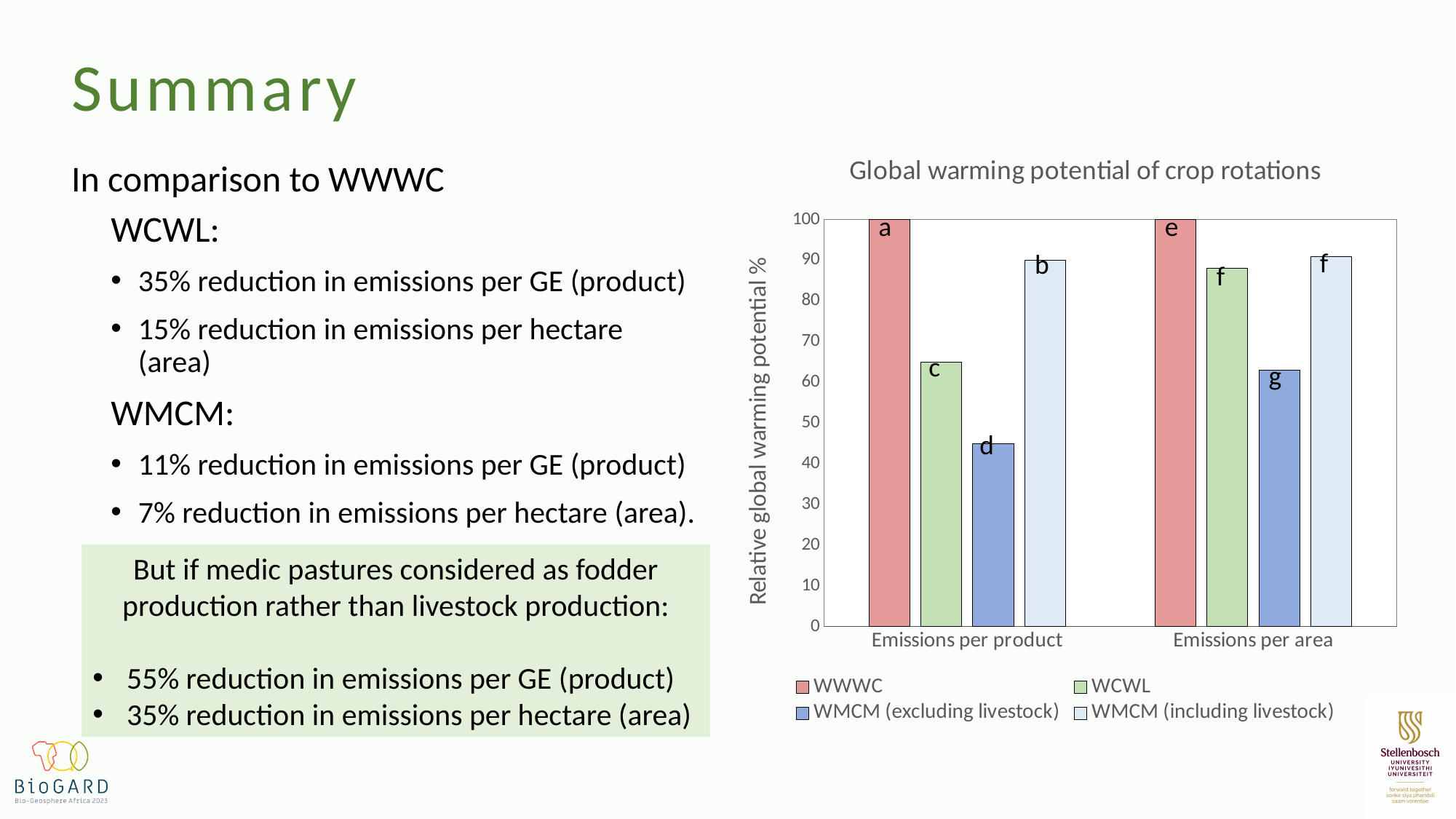
Is the value for WMCM (excluding livestock) under Emissions per product greater or less than 50? less For WCWL, which is larger: the value for Emissions per product or for Emissions per area? Emissions per area What is the relative global warming potential of WWWC for Emissions per product? 100 Which series has the highest value for Emissions per area? WWWC What is the title of the chart? Global warming potential of crop rotations How many categories are shown on the x axis of the chart? 2 What is the relative global warming potential of WWWC for Emissions per area? 100 What is the label of the y axis of the chart? Relative global warming potential % Which series has the lowest value for Emissions per product? WMCM (excluding livestock) How many series does the chart legend list? 4 What kind of chart is shown on the slide? bar chart Is the value for WCWL under Emissions per product greater or less than 70? less